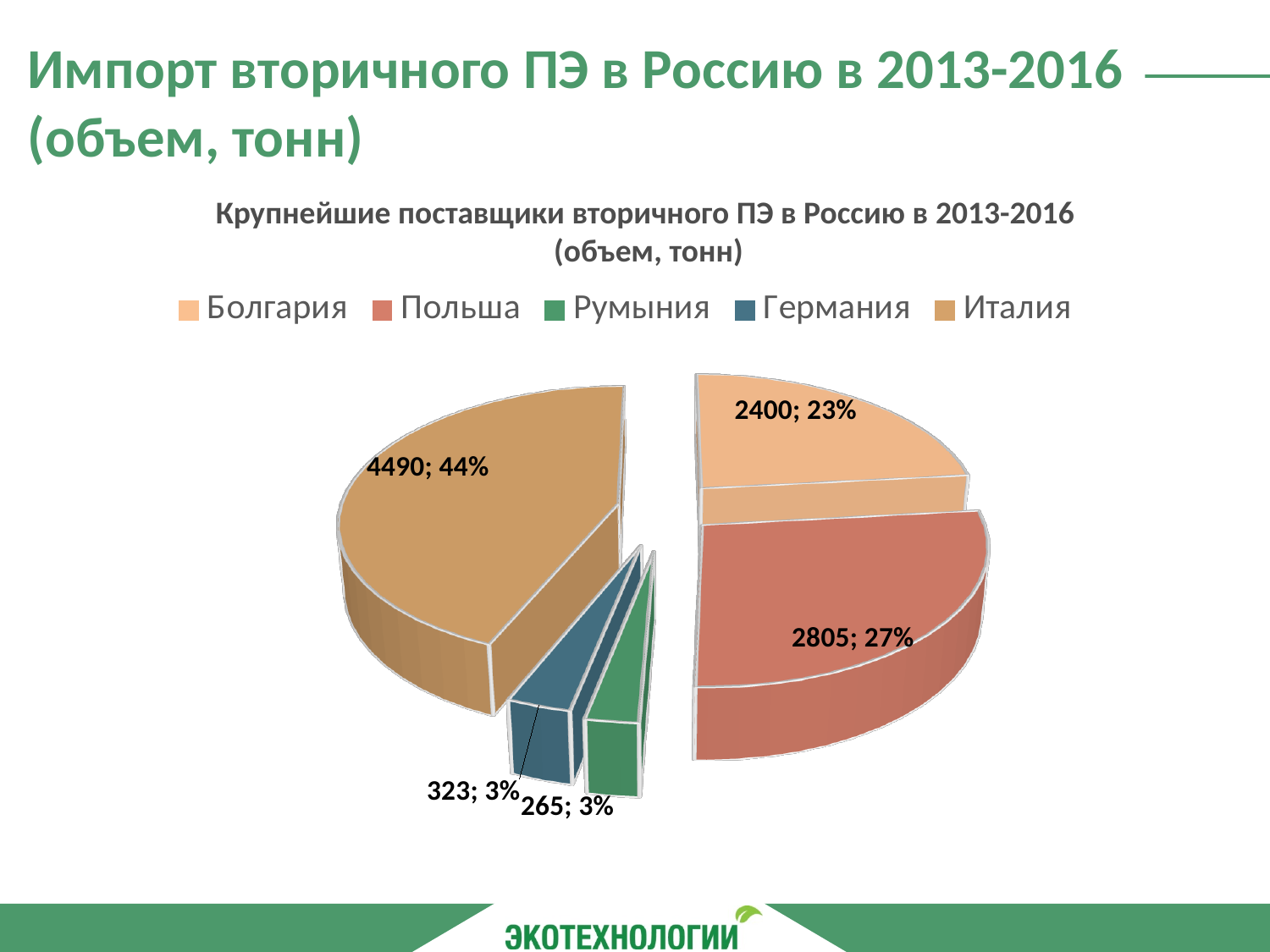
What is the value for Италия? 4490 How many countries are listed in the legend? 5 Which is larger, the value for Польша or the value for Болгария? Польша What is the value for Польша? 2805 What percentage share of the pie does Болгария have? 23% What is the value for Болгария? 2400 What is the value for Германия? 323 What type of chart is shown on the slide? pie chart Which country has the smallest value? Румыния What is the difference between the values for Италия and Польша? 1685 Which country has the largest share of the pie? Италия What is the value for Румыния? 265